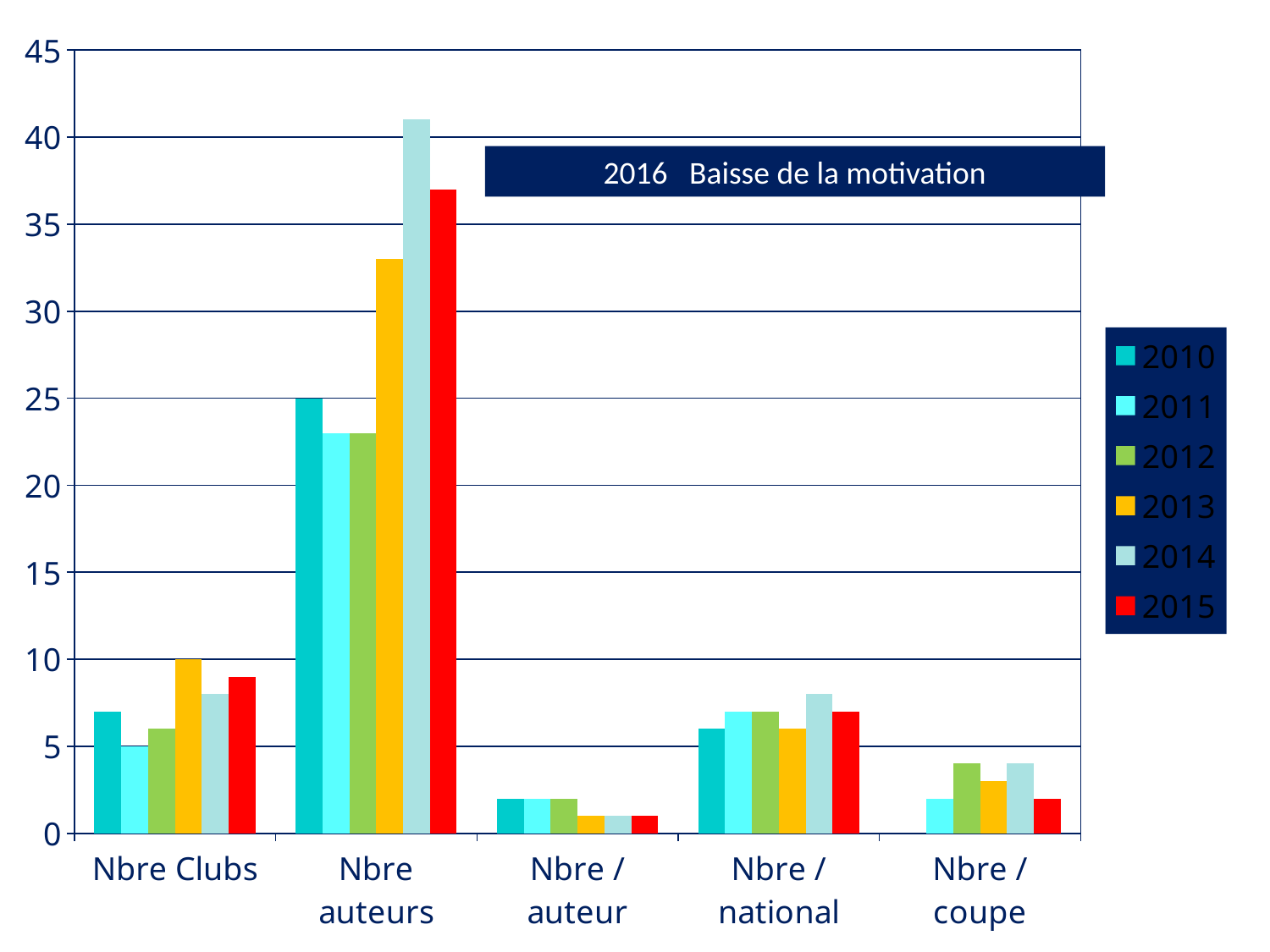
Which is larger for Nbre auteurs: the 2015 value or the 2013 value? 2015 How many categories are shown on the x axis? 5 What kind of chart is shown on the slide? bar chart Is the value for 2015 in Nbre / coupe greater or less than 5? less Is the value for 2013 in Nbre auteurs greater or less than 30? greater Which category has the highest bars overall? Nbre auteurs Which is larger for Nbre Clubs: the 2013 value or the 2012 value? 2013 Is the value for 2014 in Nbre auteurs greater or less than 40? greater Which series has the lowest value for Nbre Clubs? 2011 What text appears in the dark banner on the chart? 2016 Baisse de la motivation Which series has the highest value for Nbre auteurs? 2014 How many series does the legend list? 6